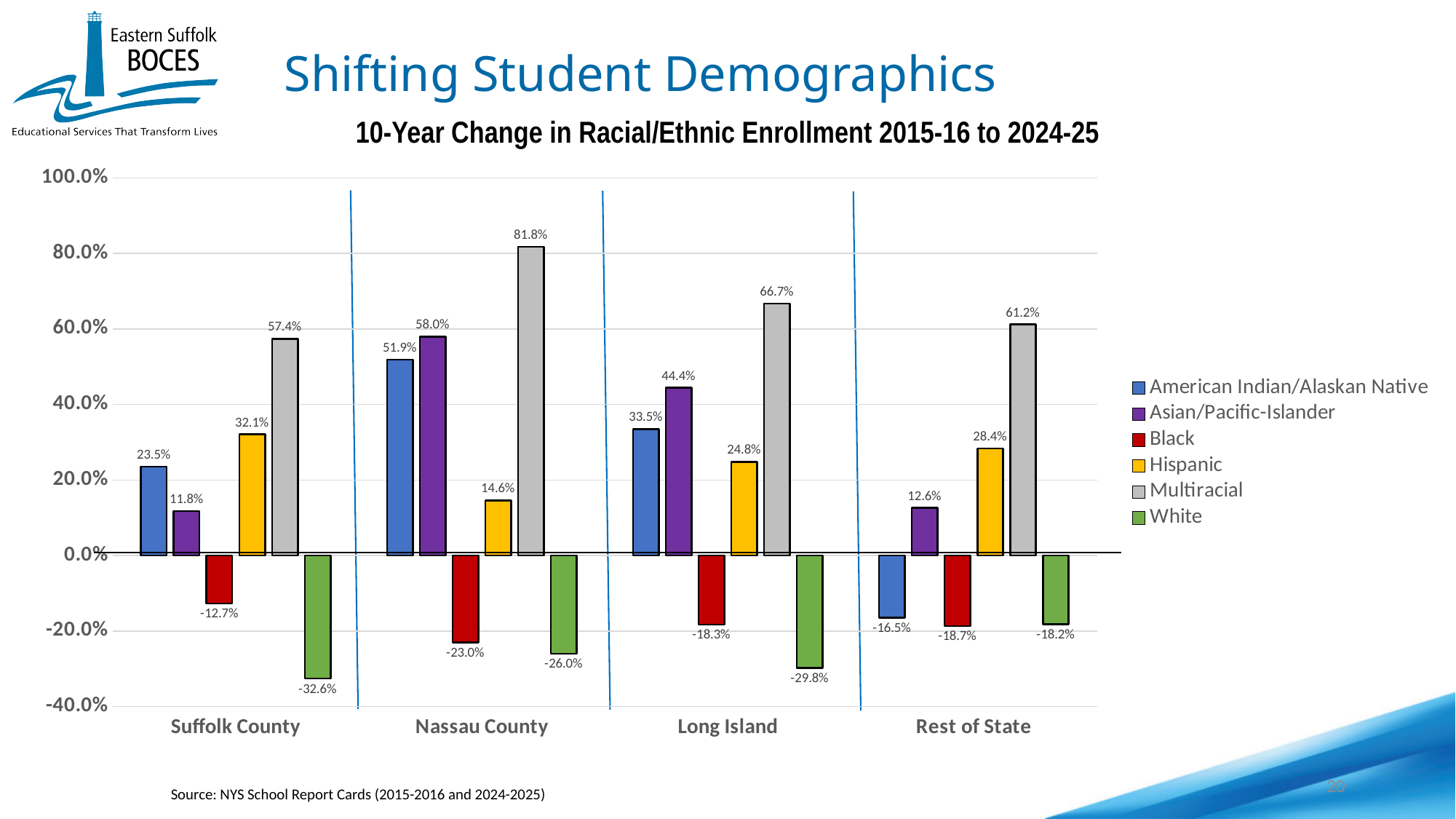
How many regions are shown on the x axis? 4 How many series does the legend list? 6 What is the difference between the Asian/Pacific-Islander change in Nassau County and in Suffolk County? 46.2% Which region has the highest 10-year change in Multiracial enrollment? Nassau County What is the 10-year change in Multiracial enrollment for Nassau County? 81.8% Is the value for American Indian/Alaskan Native in Nassau County greater or less than 40.0%? greater What kind of chart is shown on the slide? Bar chart What colour represents the Hispanic series in the chart? Yellow Which racial/ethnic group has the lowest 10-year change in Long Island? White What is the 10-year change in White enrollment for Suffolk County? -32.6% Which is larger: the Black enrollment change in Nassau County or in Long Island? Long Island What is the 10-year change in Hispanic enrollment for Rest of State? 28.4%